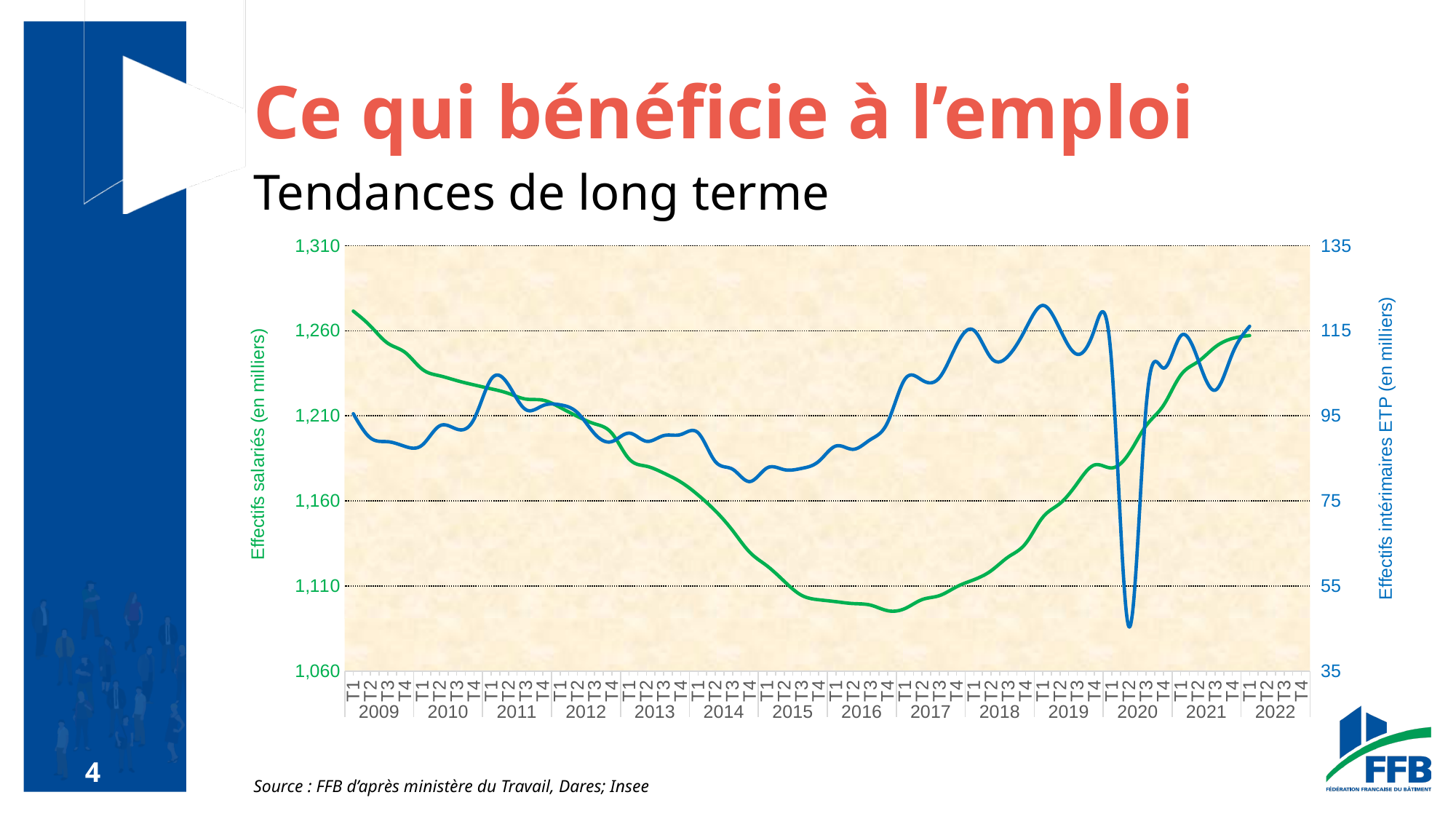
Is the value of the blue line (Effectifs intérimaires ETP) at 2020 T2 greater or less than 55? less Is the value of the green line (Effectifs salariés) at 2016 T4 greater or less than 1,110? less Does the green line (Effectifs salariés) rise or fall between 2009 and 2016? fall What is the title of the right vertical axis (blue)? Effectifs intérimaires ETP (en milliers) Is the value of the blue line (Effectifs intérimaires ETP) at 2019 T1 greater or less than 115? greater What kind of chart is shown on the slide? line chart Does the green line (Effectifs salariés) rise or fall between 2017 and 2022? rise In which quarter does the blue line (Effectifs intérimaires ETP) reach its lowest point? 2020 T2 What is the title of the left vertical axis (green)? Effectifs salariés (en milliers) How many data series are plotted on the chart? 2